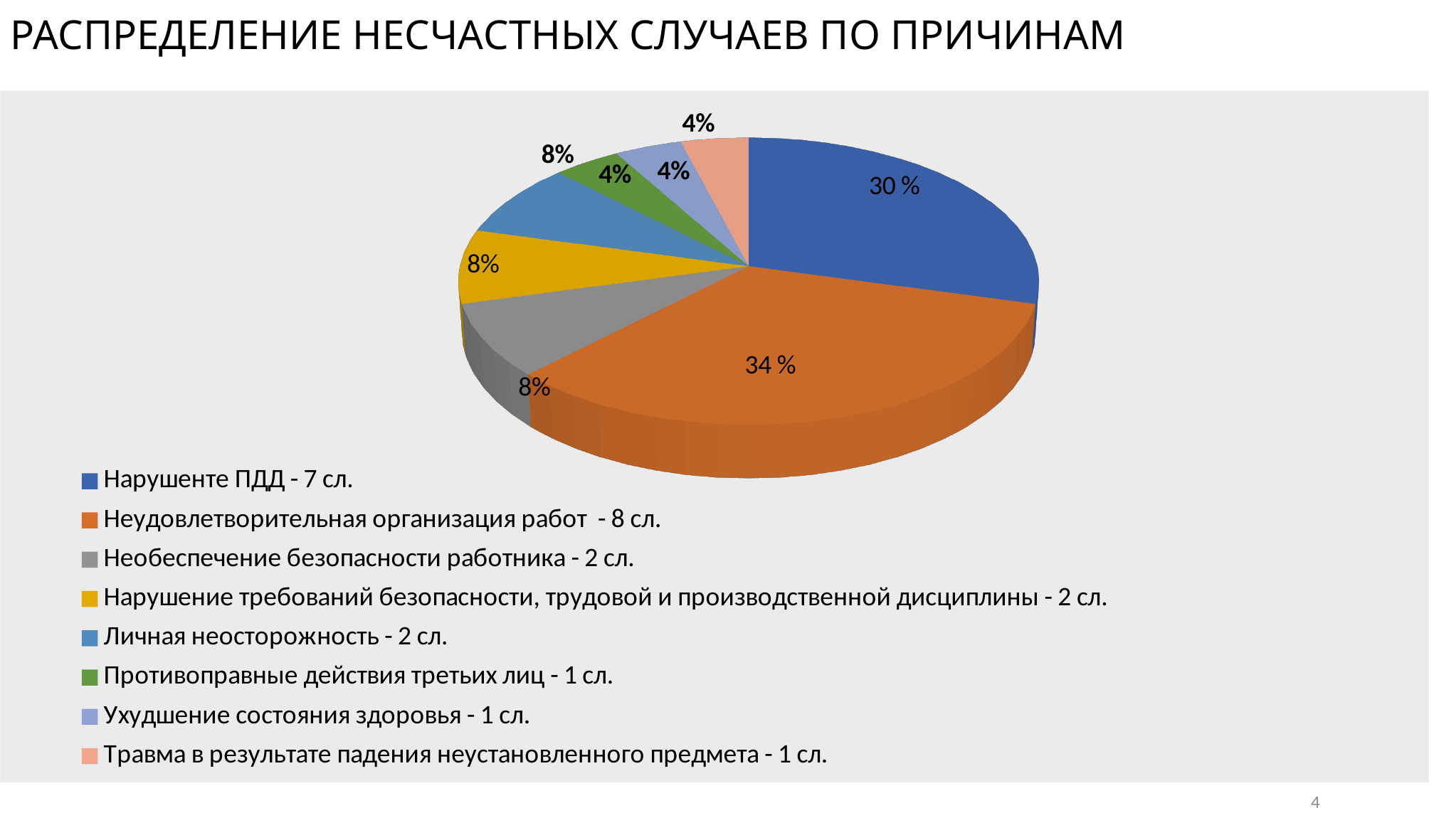
What kind of chart is shown on the slide? Pie chart How many slices does the pie chart have? 8 What is the title of the slide? РАСПРЕДЕЛЕНИЕ НЕСЧАСТНЫХ СЛУЧАЕВ ПО ПРИЧИНАМ What colour is the slice for "Необеспечение безопасности работника - 2 сл."? Gray How many categories are listed in the legend? 8 Which category has the largest slice of the pie? Неудовлетворительная организация работ - 8 сл. Which is larger: the slice for "Нарушенте ПДД - 7 сл." or the slice for "Неудовлетворительная организация работ - 8 сл."? Неудовлетворительная организация работ - 8 сл. What percentage is shown for "Ухудшение состояния здоровья - 1 сл."? 4% What share of the pie is labelled for "Неудовлетворительная организация работ - 8 сл."? 34 % What is the difference in percentage points between the "Неудовлетворительная организация работ" slice (34 %) and the "Нарушенте ПДД" slice (30 %)? 4 What share of the pie is labelled for "Нарушенте ПДД - 7 сл."? 30 % What percentage is shown for "Личная неосторожность - 2 сл."? 8%